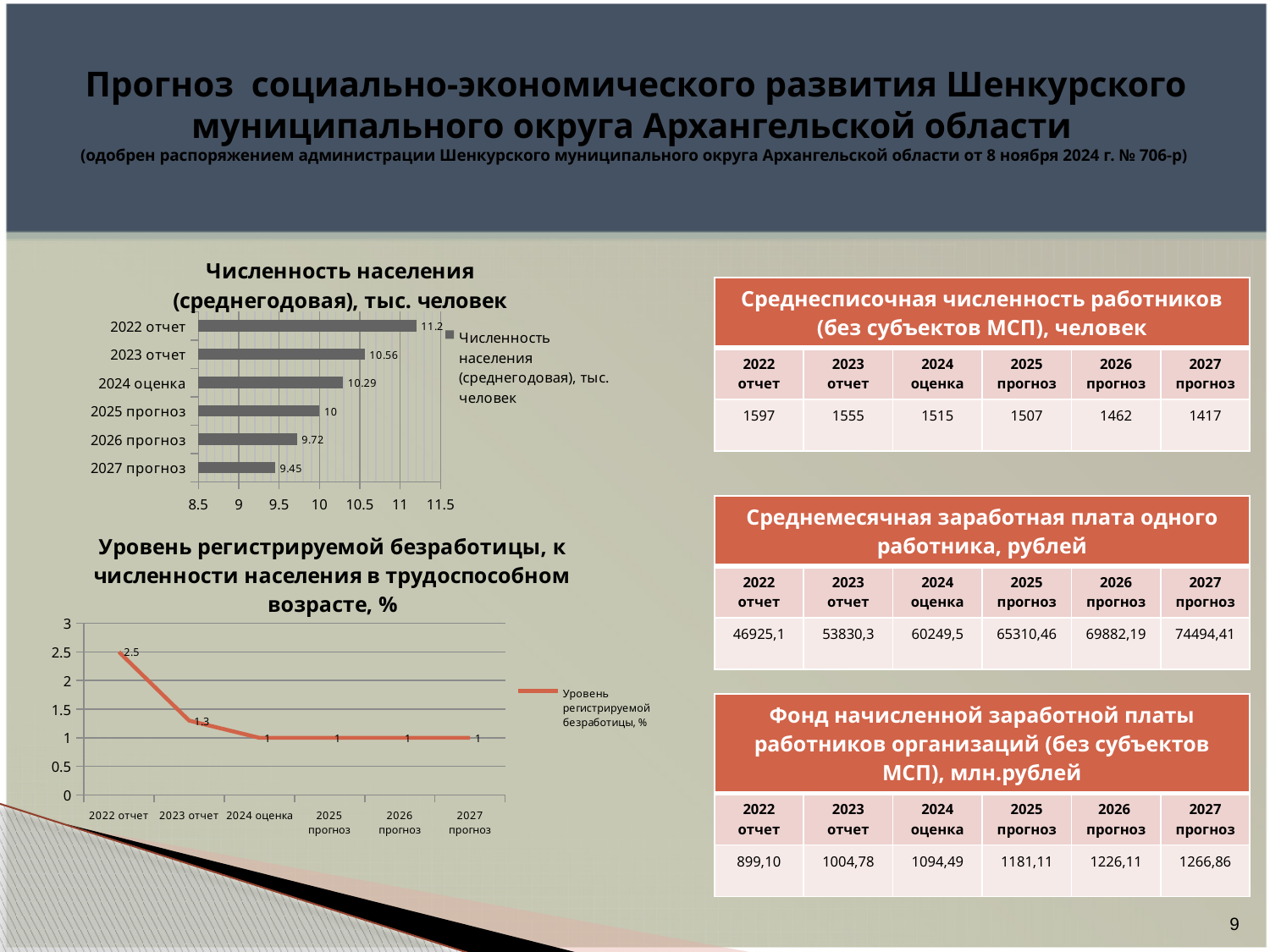
In the chart 'Уровень регистрируемой безработицы, к численности населения в трудоспособном возрасте, %', what is the difference between the values for 2022 отчет and 2023 отчет? 1.2 In the chart 'Численность населения (среднегодовая), тыс. человек', which category has the lowest value? 2027 прогноз In the chart 'Численность населения (среднегодовая), тыс. человек', what is the difference between the values for 2022 отчет and 2027 прогноз? 1.75 In the chart 'Численность населения (среднегодовая), тыс. человек', what is the value for 2022 отчет? 11.2 In the chart 'Численность населения (среднегодовая), тыс. человек', how many categories are shown? 6 In the chart 'Уровень регистрируемой безработицы, к численности населения в трудоспособном возрасте, %', what is the value for 2022 отчет? 2.5 In the chart 'Уровень регистрируемой безработицы, к численности населения в трудоспособном возрасте, %', which category has the highest value? 2022 отчет In the chart 'Численность населения (среднегодовая), тыс. человек', what is the value for 2025 прогноз? 10 In the chart 'Численность населения (среднегодовая), тыс. человек', do the values rise or fall from 2022 отчет to 2027 прогноз? fall What type of chart is 'Уровень регистрируемой безработицы, к численности населения в трудоспособном возрасте, %'? line chart What type of chart is 'Численность населения (среднегодовая), тыс. человек'? bar chart In the chart 'Уровень регистрируемой безработицы, к численности населения в трудоспособном возрасте, %', what is the value for 2023 отчет? 1.3